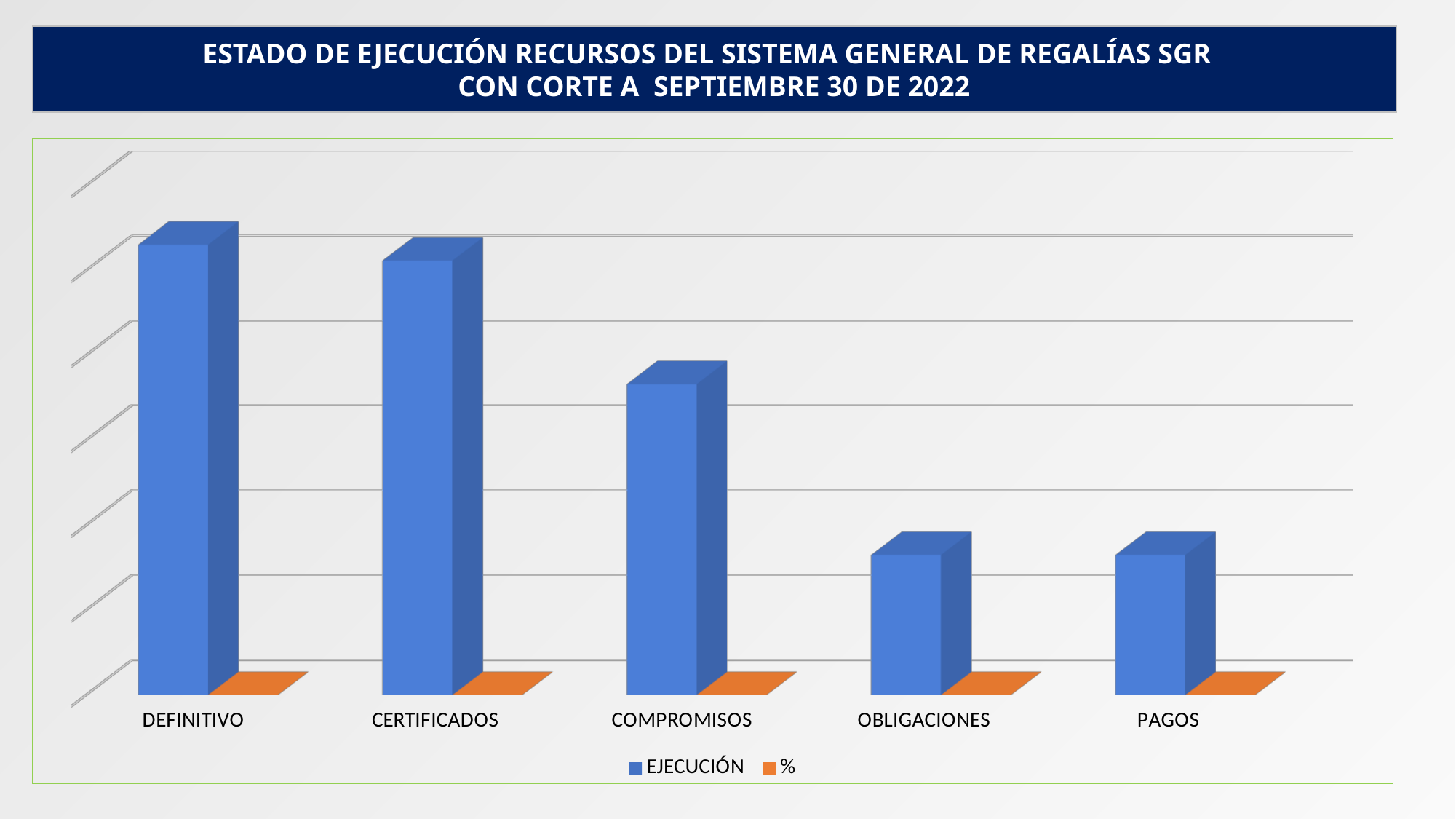
Which is larger, the EJECUCIÓN value for CERTIFICADOS or for COMPROMISOS? CERTIFICADOS How many categories are shown on the x axis? 5 How many series does the legend list? 2 Do the EJECUCIÓN values generally rise or fall from left to right across the categories? fall What are the two series named in the legend? EJECUCIÓN and % What colour are the EJECUCIÓN bars? blue Which is larger, the EJECUCIÓN value for DEFINITIVO or for PAGOS? DEFINITIVO Which category has the highest EJECUCIÓN bar? DEFINITIVO Which is larger, the EJECUCIÓN value for COMPROMISOS or for OBLIGACIONES? COMPROMISOS What kind of chart is shown on the slide? bar chart